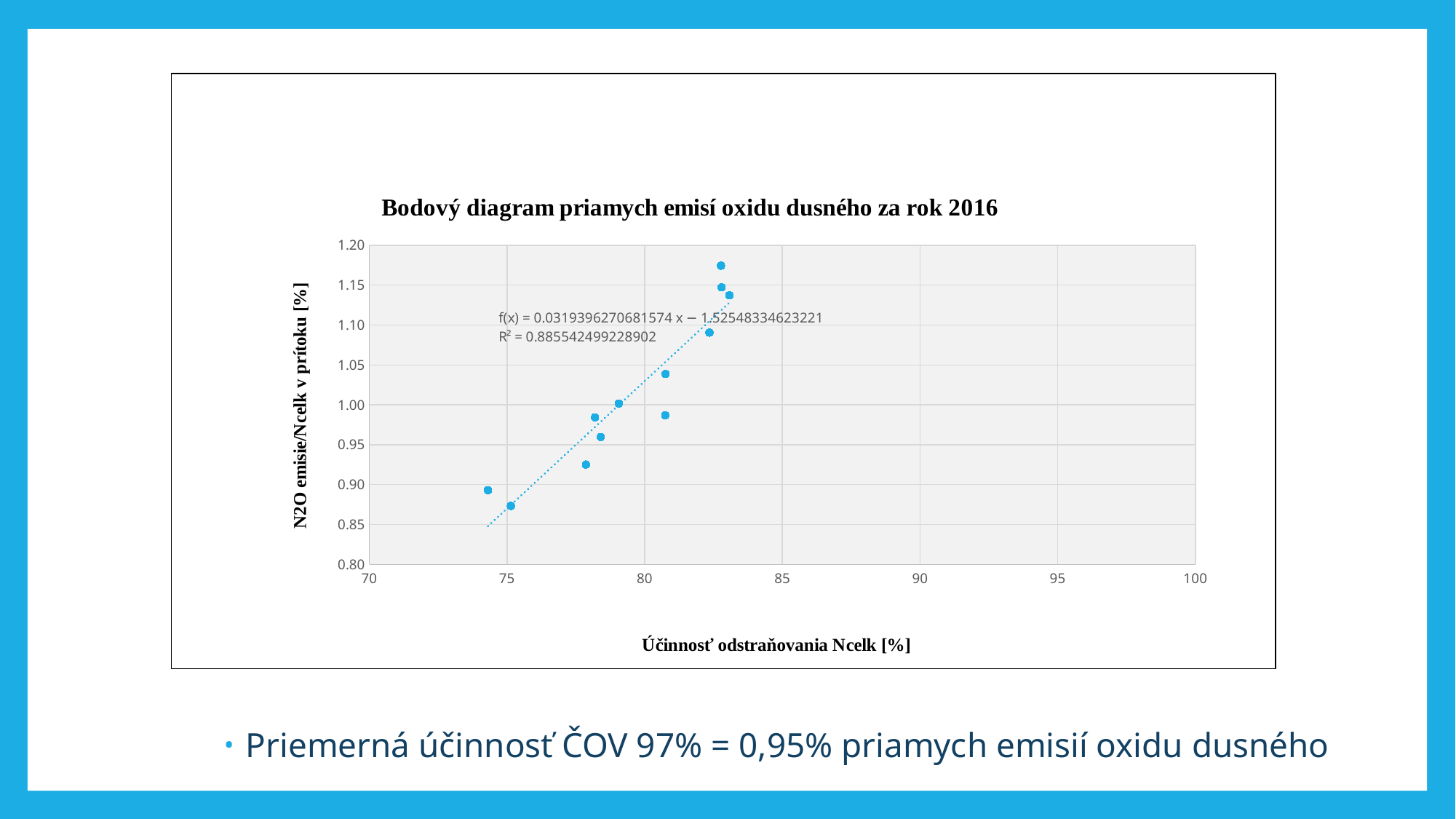
What is the label of the x axis of the chart? Účinnosť odstraňovania Ncelk [%] Do the plotted values generally rise or fall as the x-axis value (Účinnosť odstraňovania Ncelk) increases? rise Is the x value of the rightmost plotted point greater or less than 85? less What is the slope coefficient in the trendline equation printed on the chart? 0.0319396270681574 Is the x value of the leftmost plotted point greater or less than 75? less What is the highest value shown on the x axis? 100 Is the y value of the lowest plotted point greater or less than 0.90? less What kind of chart is shown on the slide? Scatter chart What R² value is printed on the chart? R² = 0.885542499228902 What is the title of the chart? Bodový diagram priamych emisí oxidu dusného za rok 2016